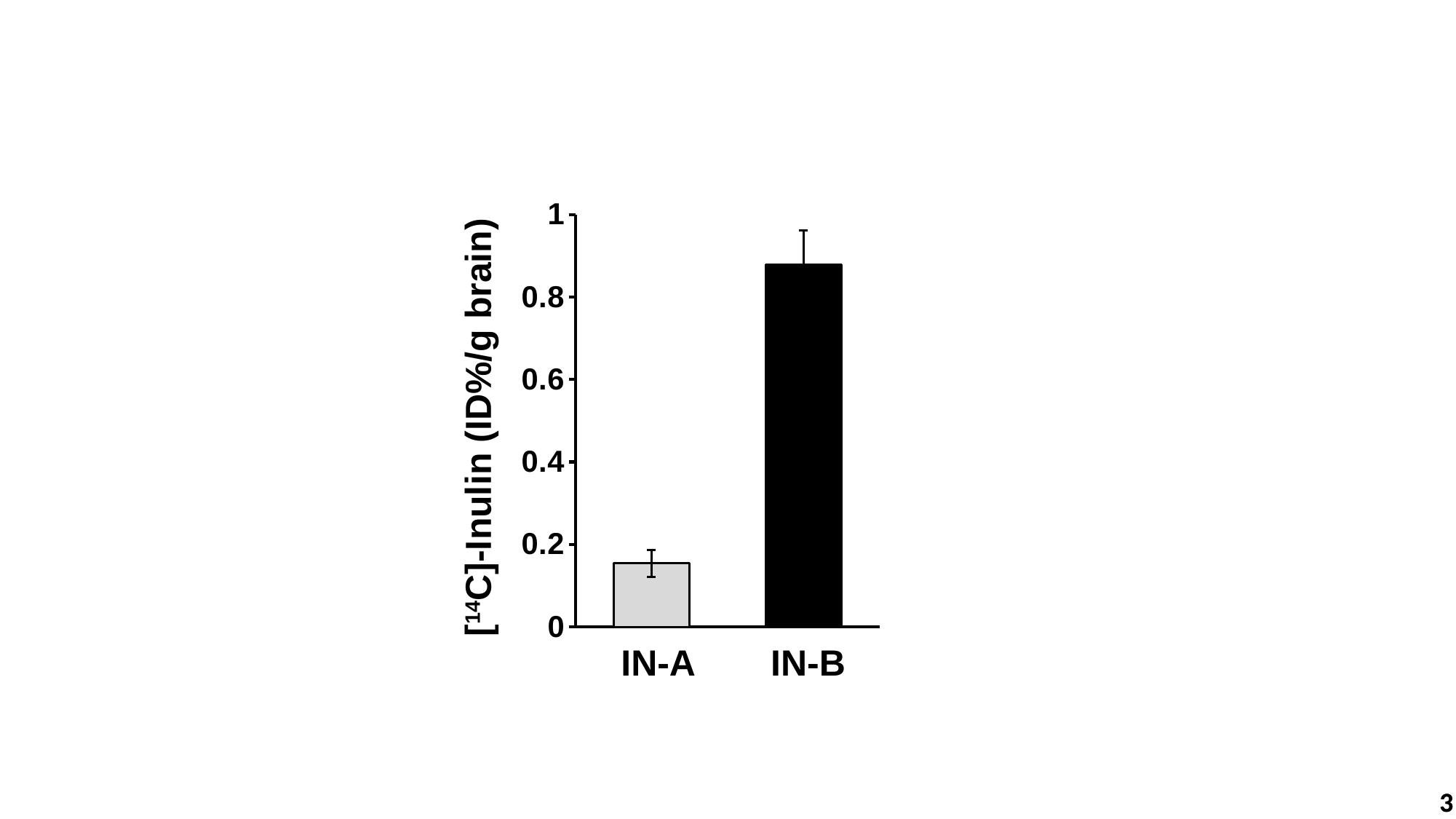
Is the value for IN-B greater or less than 0.6? greater Which category has the highest value? IN-B What colour is the bar for IN-B? black How many categories are plotted on the x axis? 2 Is the value for IN-A greater or less than 0.4? less Which is larger, the value for IN-A or the value for IN-B? IN-B Is the value for IN-B greater or less than 0.8? greater What kind of chart is shown on the slide? bar chart Which category has the lowest value? IN-A What is the label of the y axis? [14C]-Inulin (ID%/g brain) What is the maximum value shown on the y axis? 1